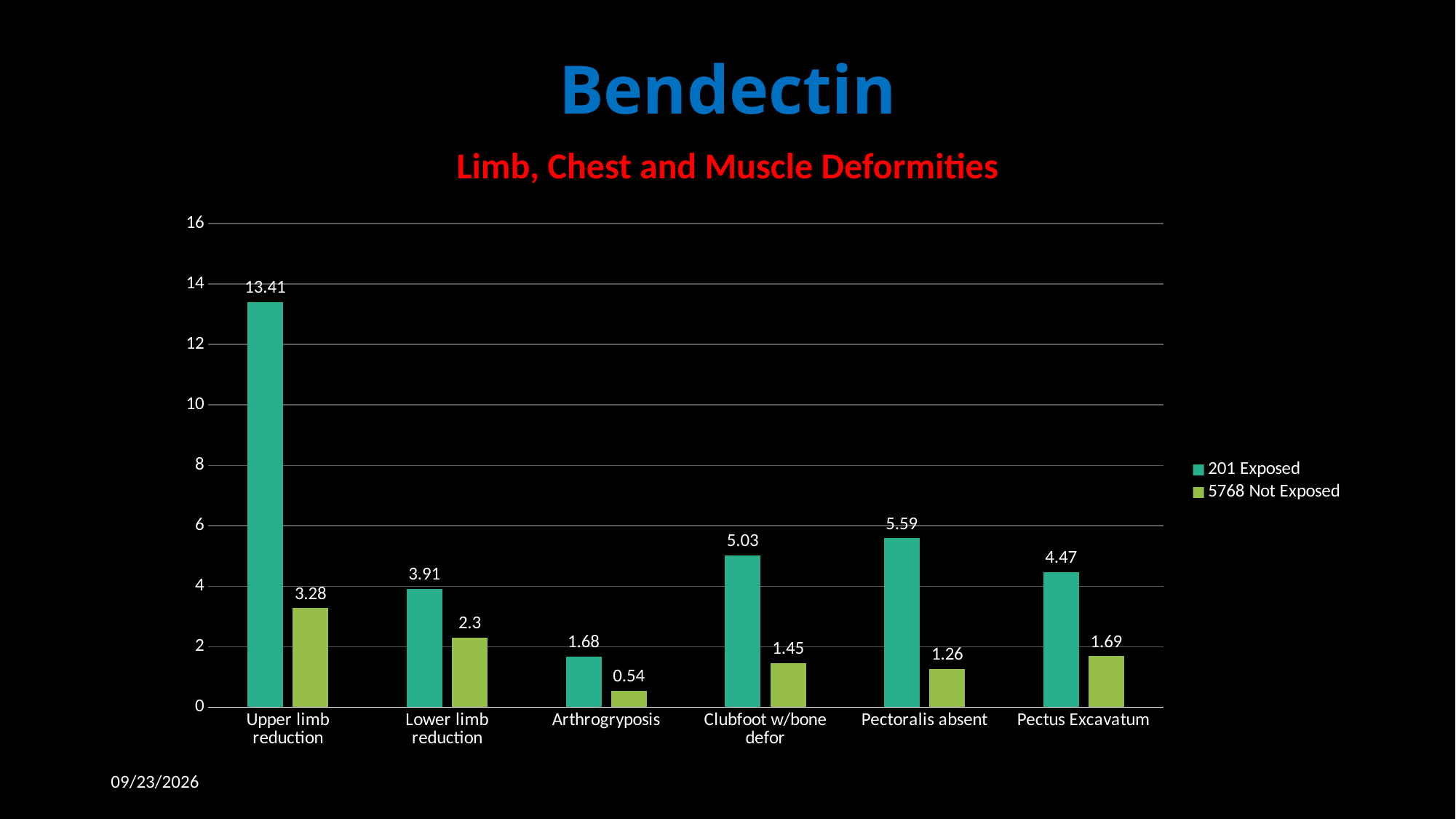
What is the value for 201 Exposed for Pectoralis absent? 5.59 Which is larger for Clubfoot w/bone defor: the 201 Exposed value or the 5768 Not Exposed value? 201 Exposed How many series does the legend list? 2 What is the chart's subtitle shown in red? Limb, Chest and Muscle Deformities What is the value for 201 Exposed for Upper limb reduction? 13.41 How many categories are shown on the x axis? 6 Which category has the highest value for 201 Exposed? Upper limb reduction What is the value for 5768 Not Exposed for Arthrogryposis? 0.54 Which category has the lowest value for 5768 Not Exposed? Arthrogryposis What is the value for 5768 Not Exposed for Pectus Excavatum? 1.69 What is the difference between the 201 Exposed and 5768 Not Exposed values for Upper limb reduction? 10.13 What kind of chart is shown on the slide? Bar chart